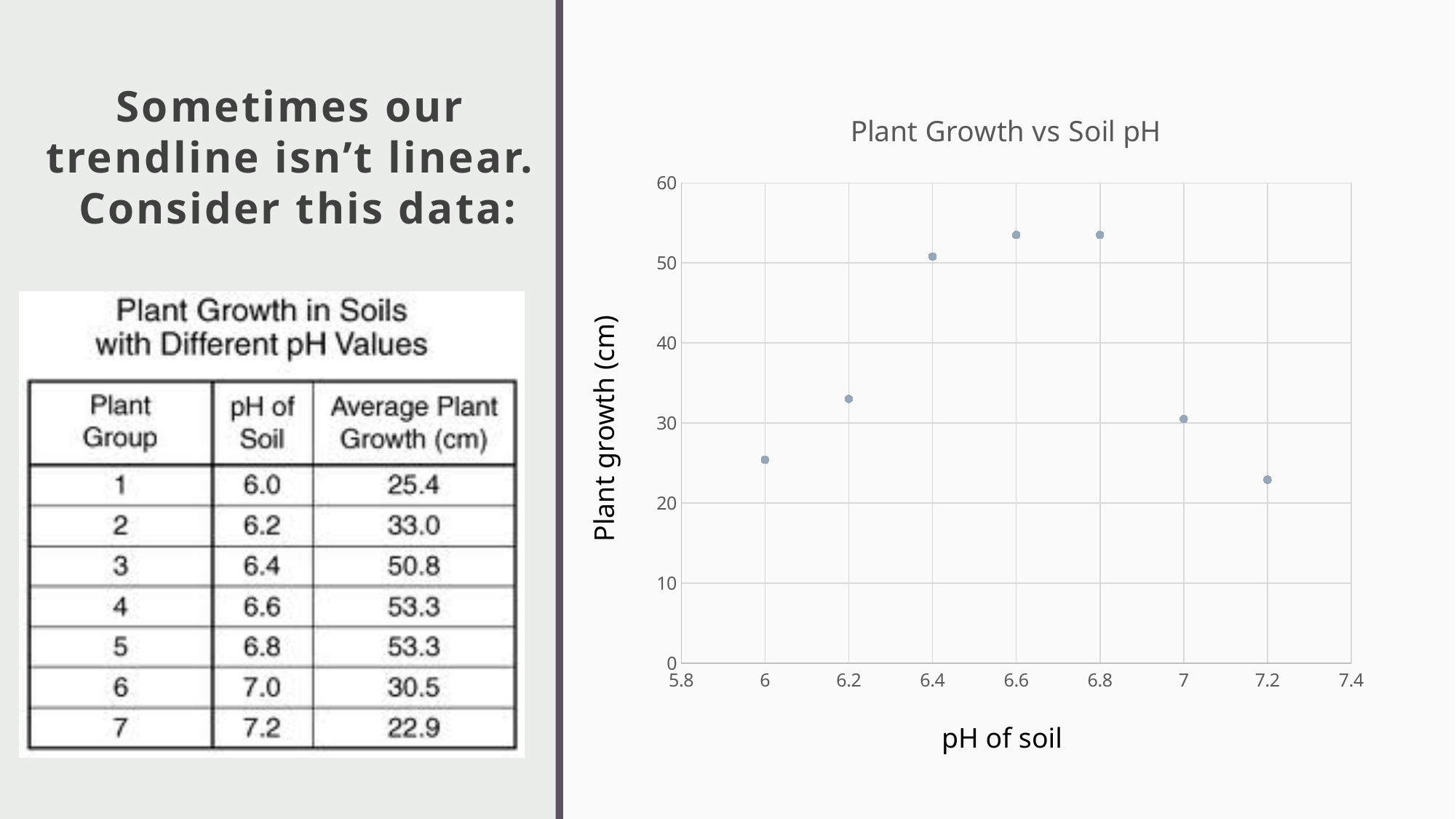
According to the table on the slide, what is the difference in average plant growth between pH 6.6 and pH 6.0? 27.9 Is the plant growth value at pH 7.2 greater or less than 30? less What kind of chart is shown on the slide? Scatter chart Which has the larger plant growth value, pH 7.0 or pH 6.4? pH 6.4 Is the plant growth value at pH 6.0 greater or less than 30? less What is the label of the vertical axis of the chart? Plant growth (cm) Which has the larger plant growth value, pH 6.2 or pH 6.6? pH 6.6 Is the plant growth value at pH 6.4 greater or less than 50? greater Do the plant growth values rise or fall as pH increases from 6.8 to 7.2? fall According to the table on the slide, what is the average plant growth at a soil pH of 6.4? 50.8 How many data points are plotted on the chart? 7 What is the title of the chart? Plant Growth vs Soil pH